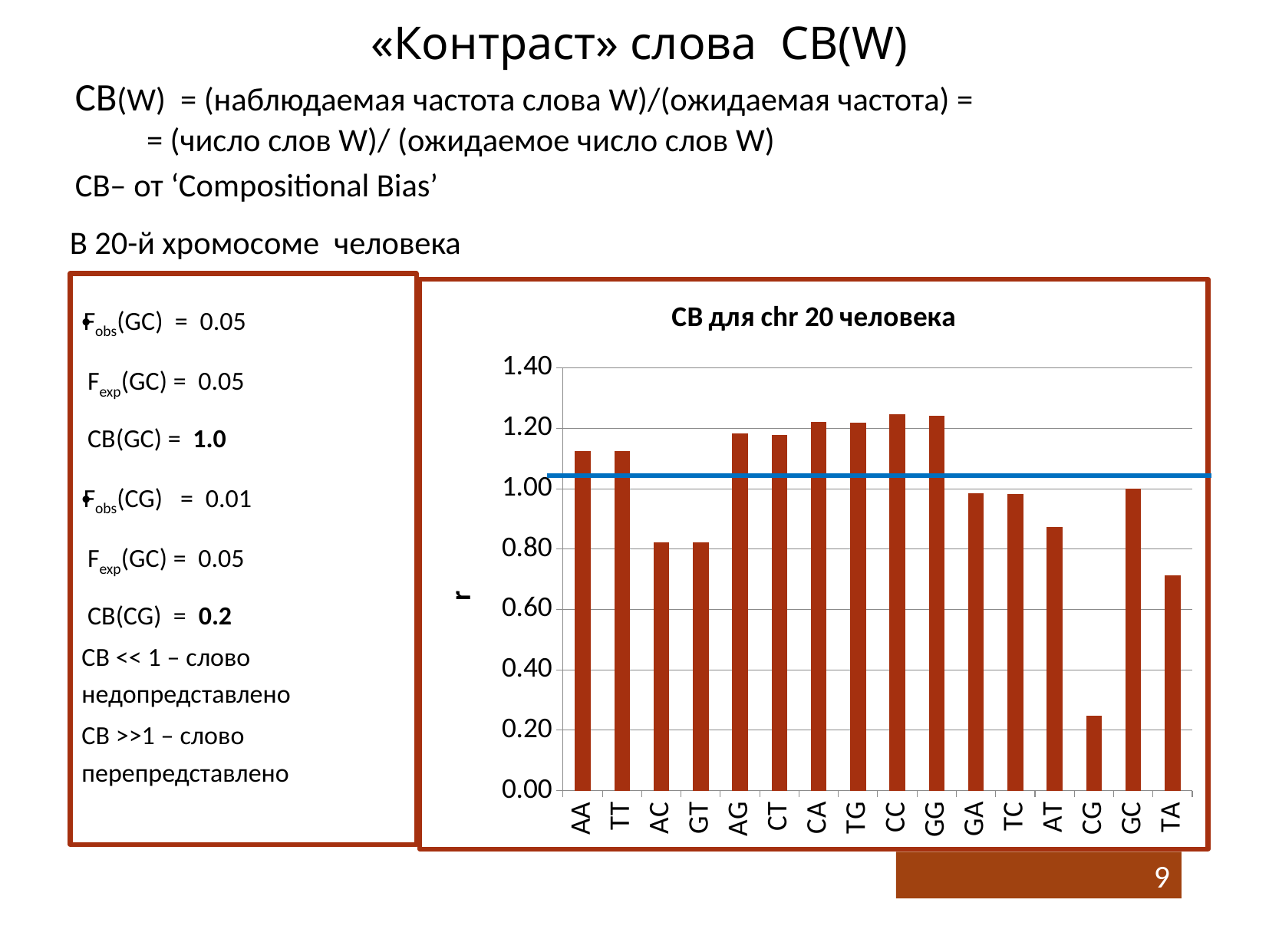
How many categories (dinucleotide words) are shown on the x axis of the chart? 16 What is the label on the vertical axis of the chart? r What kind of chart is shown on the slide? bar chart Is the value for AC greater or less than 1.00? less Which has the larger value, AA or AC? AA What is the title of the chart? CB для chr 20 человека Which has the larger value, CG or TA? TA Is the value for TA greater or less than 0.60? greater Which category has the lowest value in the chart? CG Is the value for CC greater or less than 1.20? greater